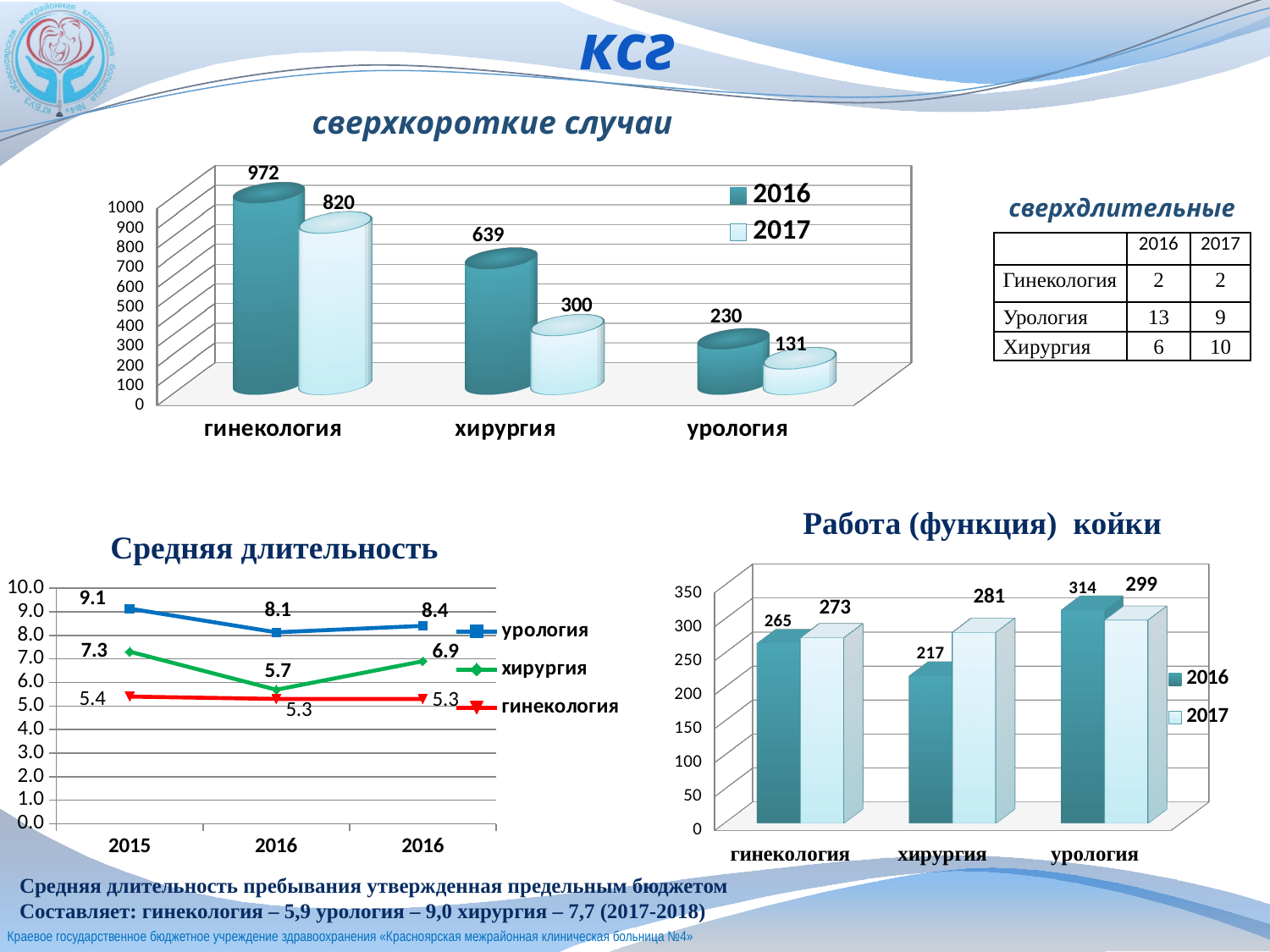
In the 'сверхкороткие случаи' chart, what is the difference between the 2016 and 2017 values for гинекология? 152 In the 'Средняя длительность' chart, what is the lowest value plotted for хирургия? 5.7 In the 'Работа (функция) койки' chart, which is larger for урология: 2016 or 2017? 2016 In the 'Работа (функция) койки' chart, what is the difference between the 2017 and 2016 values for хирургия? 64 In the 'сверхкороткие случаи' chart, which category has the lowest value for 2017? урология In the 'сверхкороткие случаи' chart, what is the value for хирургия in 2017? 300 What kind of chart is 'Средняя длительность'? line chart In the 'Средняя длительность' chart, what is the value for урология in 2015? 9.1 In the 'сверхкороткие случаи' chart, how many series does the legend list? 2 In the 'сверхкороткие случаи' chart, what is the value for гинекология in 2016? 972 In the 'Средняя длительность' chart, how many series does the legend list? 3 In the 'Работа (функция) койки' chart, what is the value for хирургия in 2016? 217